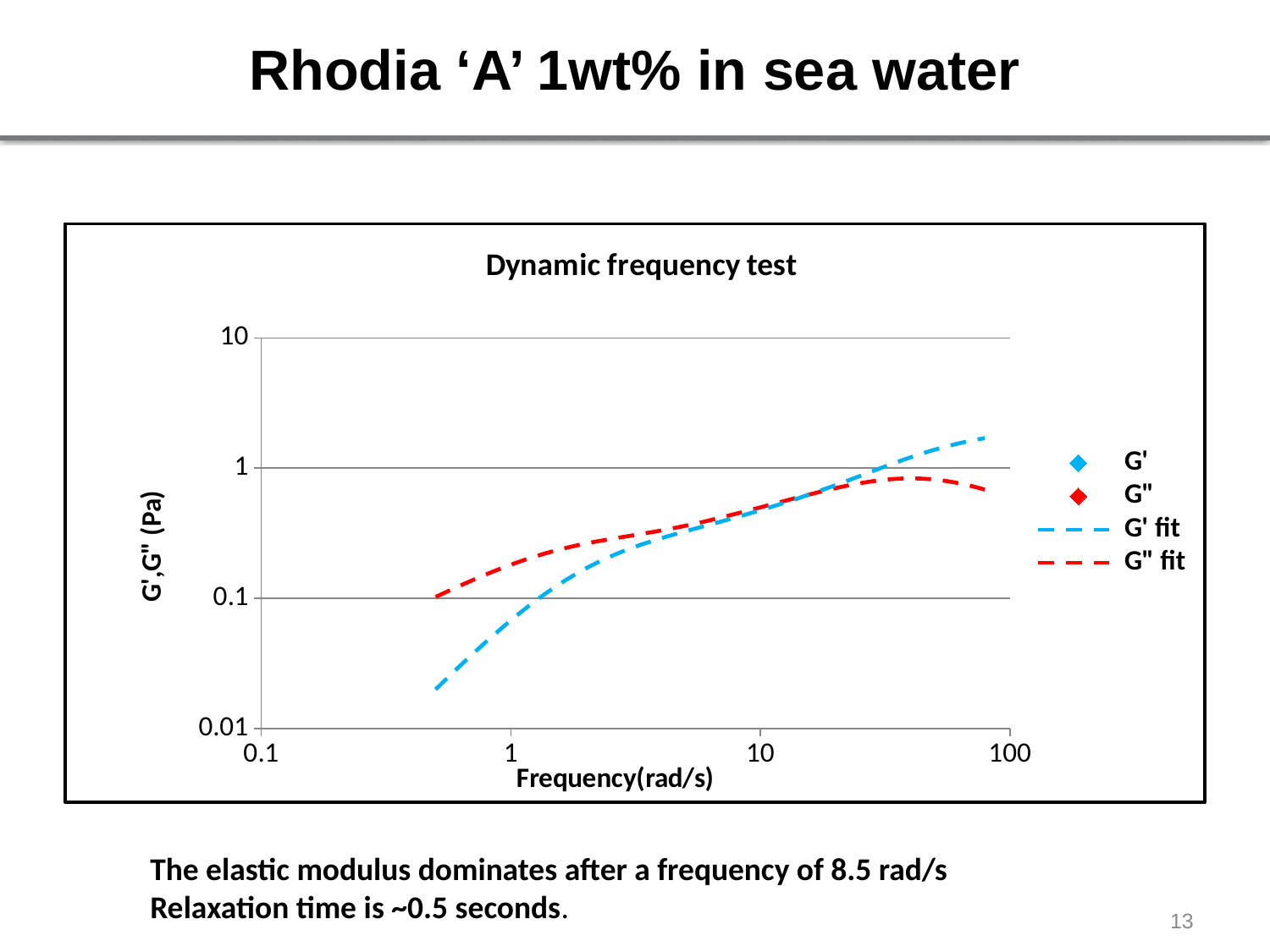
How many series does the legend list? 4 Is the value of G' fit at a frequency of 0.5 rad/s greater or less than 0.1? less What is the title of the chart? Dynamic frequency test Is the value of G" fit at a frequency of 10 rad/s greater or less than 0.1? greater At a frequency of 50 rad/s, which is larger, G' fit or G" fit? G' fit What kind of chart is shown on the slide? line chart What is the highest tick value shown on the y axis? 10 At a frequency of 1 rad/s, which is larger, G' fit or G" fit? G" fit Which fit curve reaches the highest value on the chart? G' fit Does the G' fit curve rise or fall as frequency increases? rise Is the value of G' fit at a frequency of 10 rad/s greater or less than 1? less What is the label of the x axis? Frequency(rad/s)